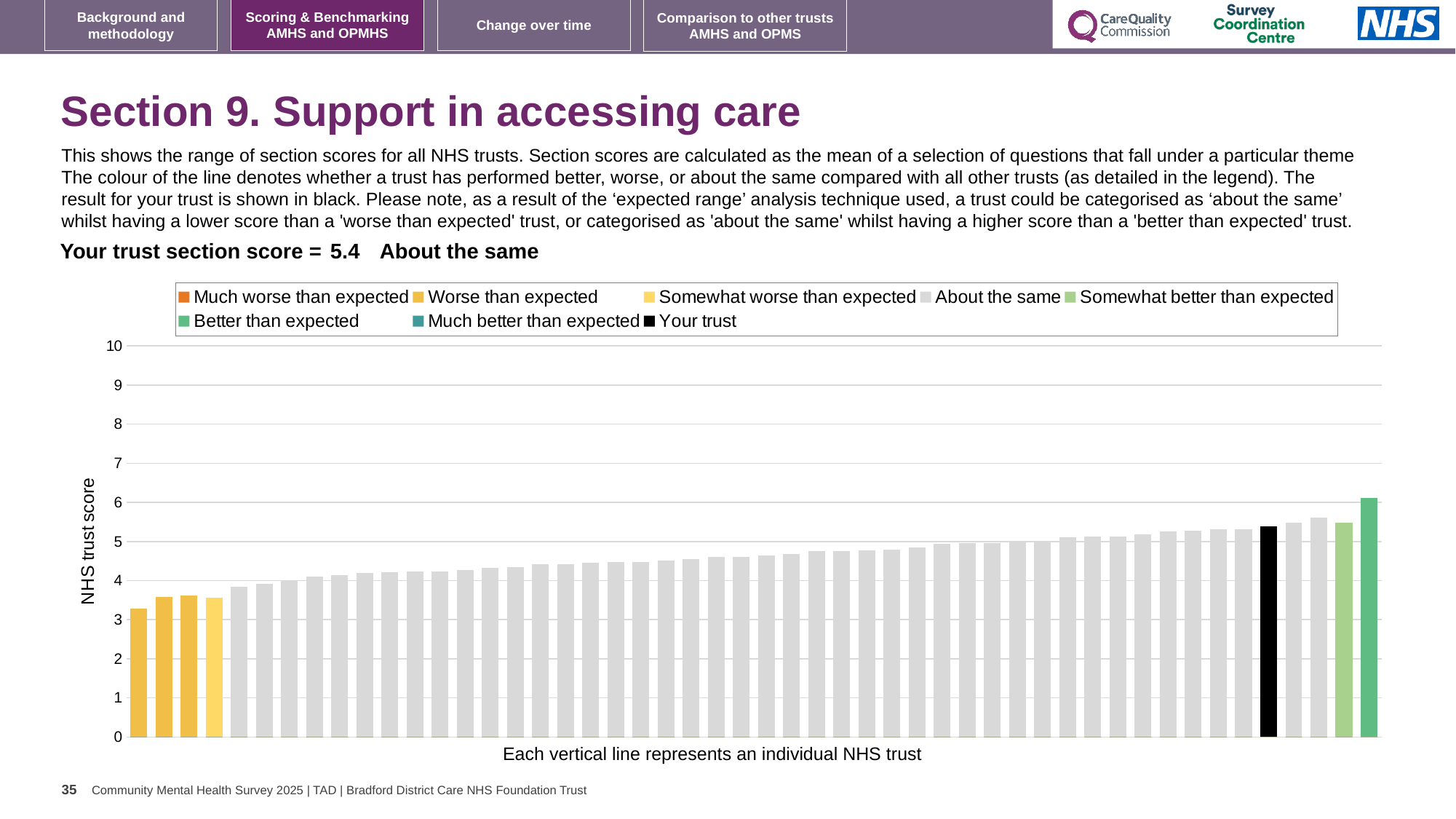
How many entries does the chart legend list? 8 What kind of chart is shown on the slide? bar chart Which legend category does the tallest bar in the chart belong to? Better than expected What is the section score for your trust shown on the slide? 5.4 How many bars are coloured in the 'Better than expected' green colour? 1 Is the value of the black 'Your trust' bar greater or less than 5? greater What colour is the bar representing your trust? black What is the label on the vertical axis of the chart? NHS trust score Do the bar values rise or fall from left to right along the x axis? rise How many bars are coloured in the 'Worse than expected' yellow colour? 3 Is the value of the lowest bar in the chart greater or less than 3? greater Is the value of the lowest bar in the chart greater or less than 4? less